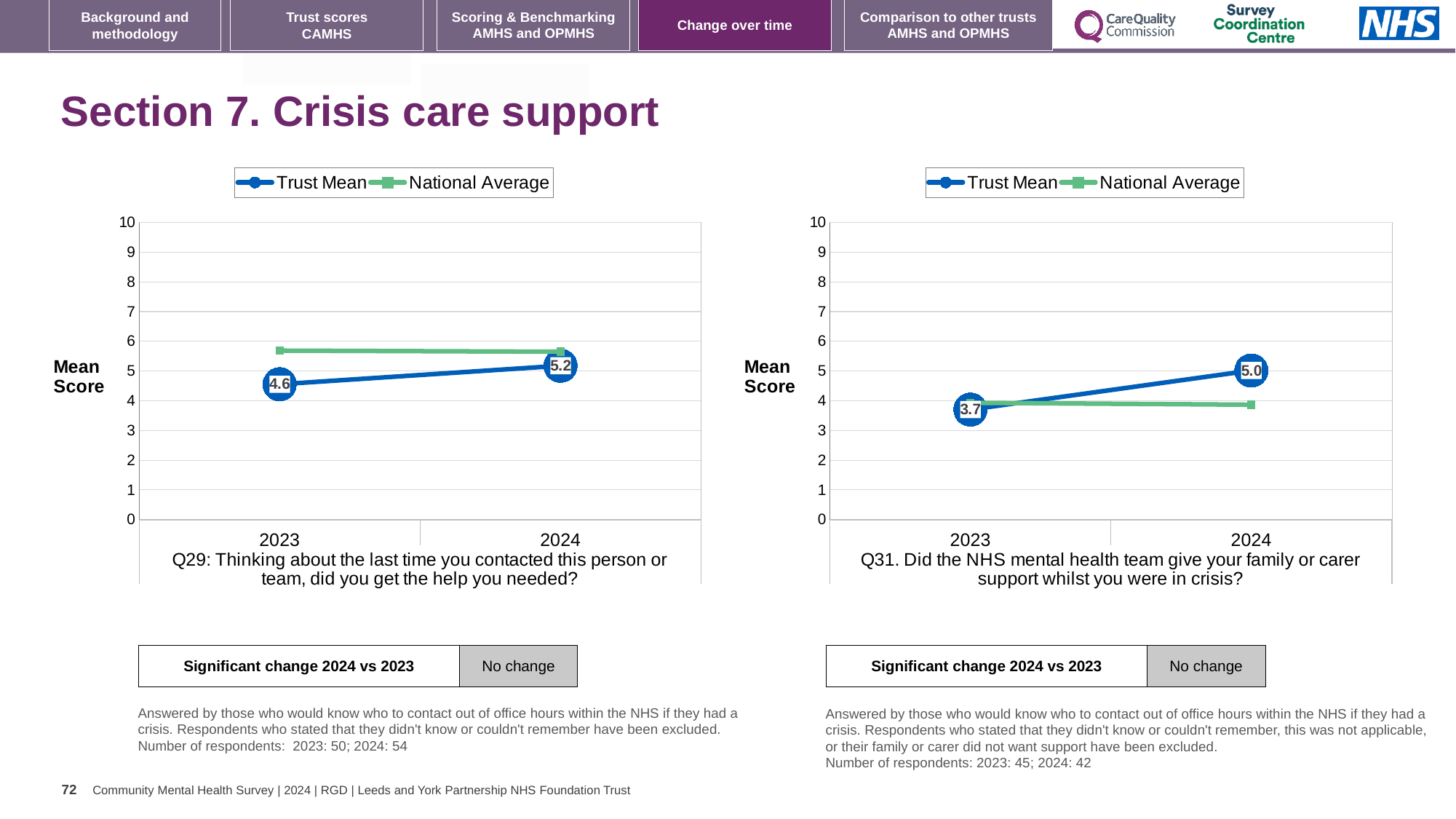
In the Q31 chart, what is the Trust Mean score for 2024? 5.0 In the Q31 chart, what is the Trust Mean score for 2023? 3.7 In the Q31 chart, by how much did the Trust Mean change from 2023 to 2024? 1.3 In the Q29 chart, what is the Trust Mean score for 2023? 4.6 In the Q29 chart, by how much did the Trust Mean change from 2023 to 2024? 0.6 In the Q31 chart, is the Trust Mean or the National Average higher in 2024? Trust Mean In the Q31 chart, does the Trust Mean rise or fall from 2023 to 2024? rise In the Q29 chart, what is the Trust Mean score for 2024? 5.2 In the Q29 chart, is the National Average for 2023 greater or less than 5? greater How many series does the legend of the Q31 chart list? 2 What type of chart is the Q29 chart? line chart In the Q29 chart, is the Trust Mean or the National Average higher in 2023? National Average